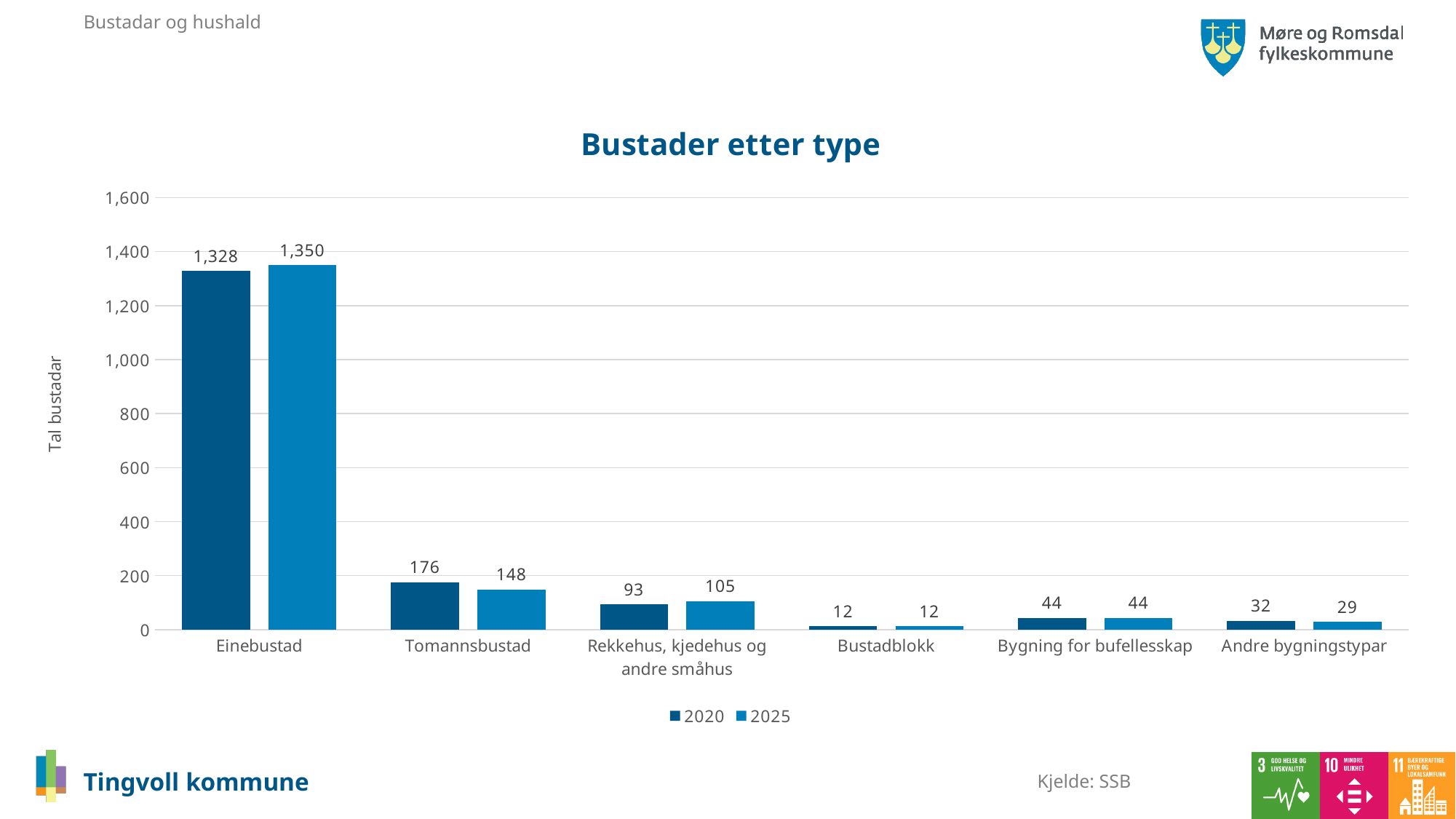
Which category has the lowest value in 2025? Bustadblokk Which is larger for Rekkehus, kjedehus og andre småhus: the 2020 value or the 2025 value? 2025 What is the value for Bustadblokk in 2025? 12 Which category has the highest value in 2020? Einebustad What kind of chart is shown on the slide? bar chart What is the difference between the 2025 and 2020 values for Einebustad? 22 How many series does the legend list? 2 What is the difference between the 2020 and 2025 values for Tomannsbustad? 28 How many categories are shown on the x axis? 6 Is the 2020 value for Einebustad greater or less than 1,200? greater What is the value for Tomannsbustad in 2020? 176 What is the value for Einebustad in 2025? 1,350